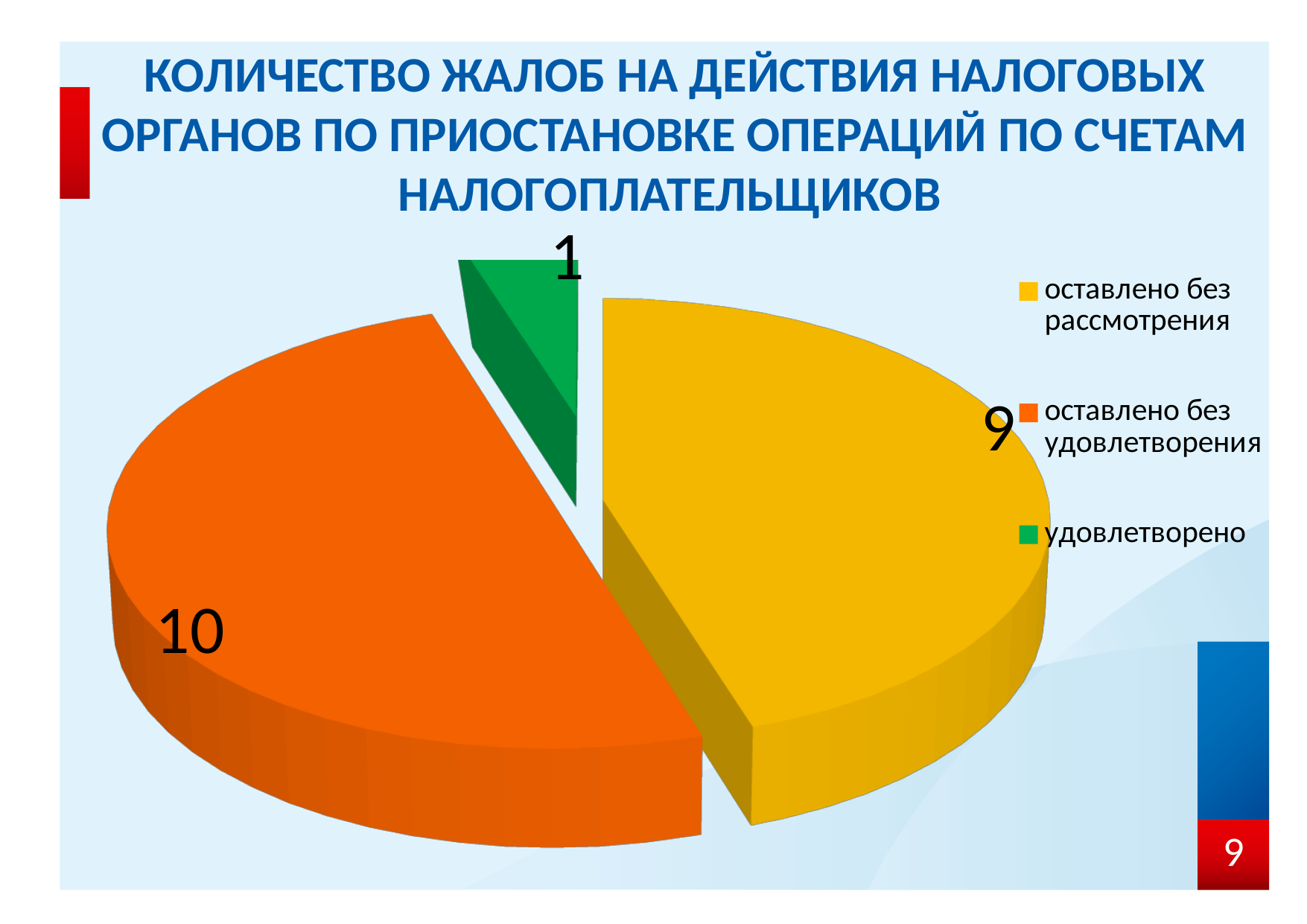
Which colour represents «удовлетворено» in the chart? Green What is the value for «оставлено без удовлетворения»? 10 Which is larger: «оставлено без рассмотрения» or «удовлетворено»? оставлено без рассмотрения What is the difference between the values for «оставлено без удовлетворения» and «удовлетворено»? 9 What share of the pie does «оставлено без удовлетворения» represent? 50% Which category has the smallest slice? удовлетворено What is the value for «удовлетворено»? 1 How many slices does the pie chart have? 3 What type of chart is shown on the slide? Pie chart How many entries does the legend list? 3 What is the value for «оставлено без рассмотрения»? 9 Which category has the largest slice? оставлено без удовлетворения